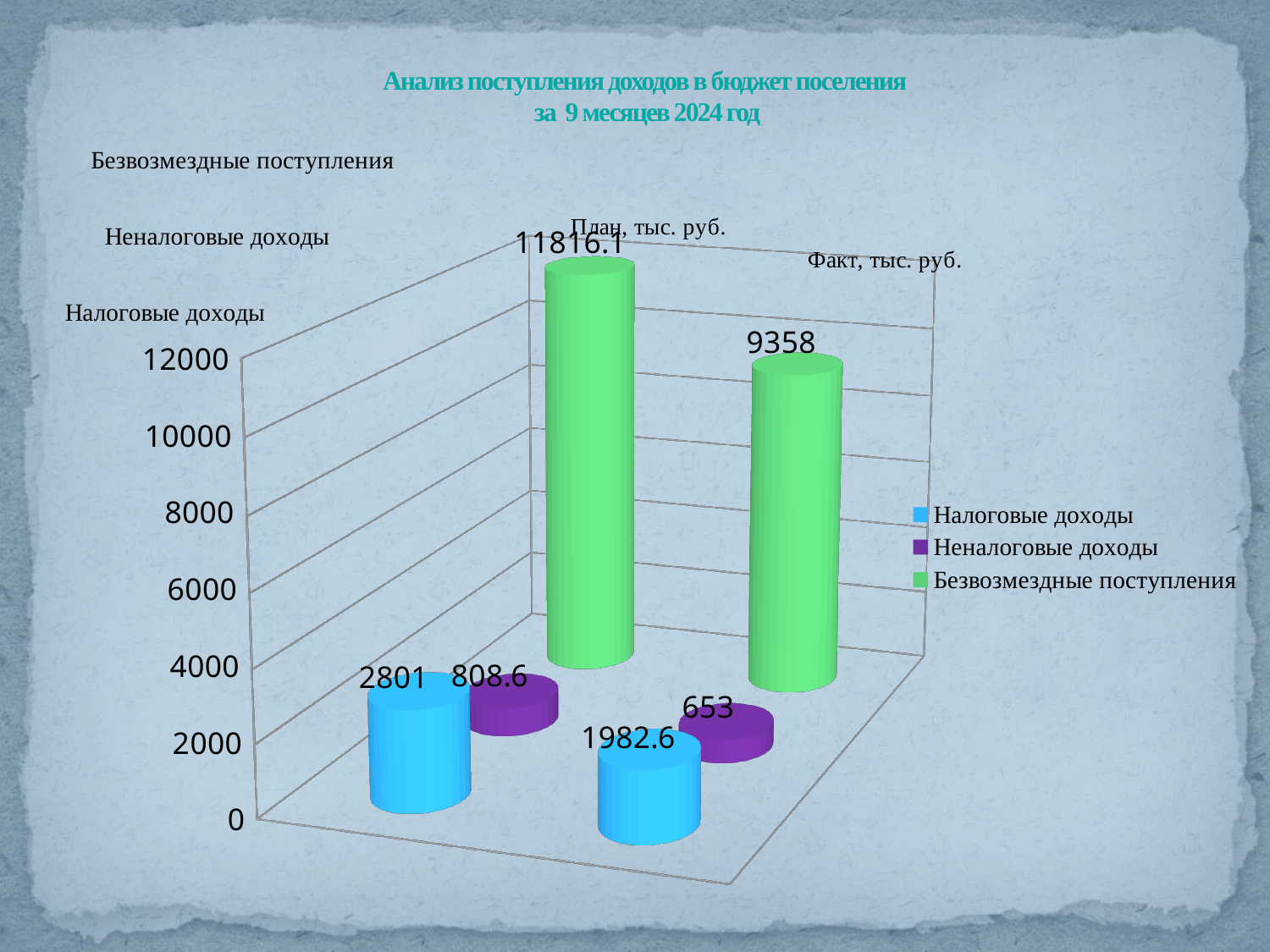
Which series has the lowest actual value (Факт, тыс. руб.)? Неналоговые доходы Which is larger for Неналоговые доходы: the planned value or the actual value? the planned value (808.6) What is the difference between the planned and actual values for Безвозмездные поступления? 2458.1 Is the actual value (Факт) for Безвозмездные поступления greater or less than 8000? greater What is the planned value (План, тыс. руб.) for Неналоговые доходы? 808.6 How many series does the legend list? 3 What is the actual value (Факт, тыс. руб.) for Налоговые доходы? 1982.6 What is the planned value (План, тыс. руб.) for Налоговые доходы? 2801 What kind of chart is shown on the slide? bar chart What is the actual value (Факт, тыс. руб.) for Безвозмездные поступления? 9358 What colour represents Безвозмездные поступления in the chart? green Which series has the highest planned value (План, тыс. руб.)? Безвозмездные поступления